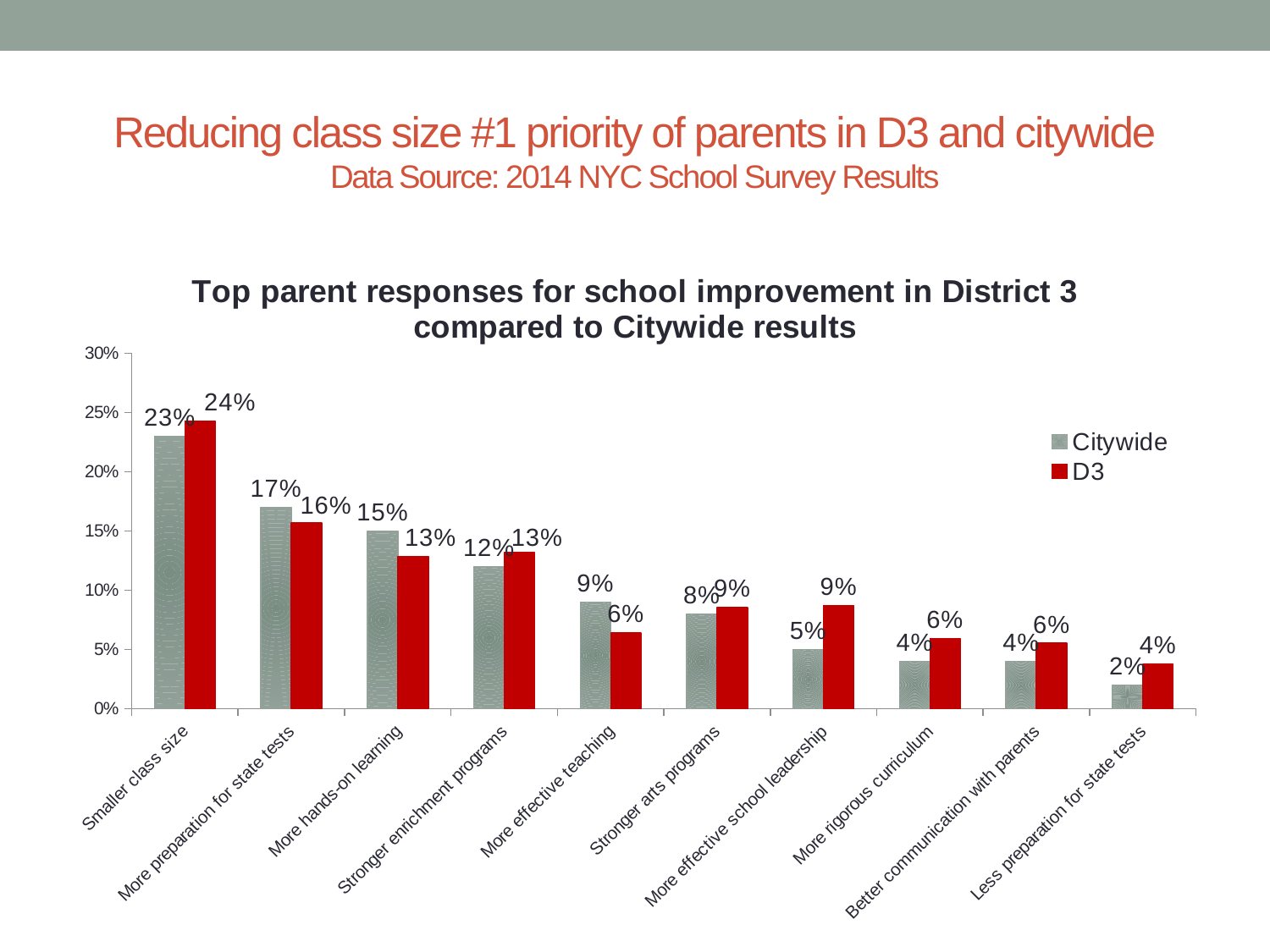
Is the Citywide value for More preparation for state tests greater or less than 15%? greater What kind of chart is shown on the slide? Bar chart What is the difference between the D3 and Citywide values for More effective school leadership? 4% How many categories are shown on the x axis? 10 How many series does the legend list? 2 Which category has the highest Citywide value? Smaller class size What is the D3 value for Less preparation for state tests? 4% What is the Citywide value for More effective school leadership? 5% Which category has the lowest D3 value? Less preparation for state tests Which series is shown in red in the legend? D3 For More effective teaching, which is larger: the Citywide value or the D3 value? Citywide What is the D3 value for Smaller class size? 24%